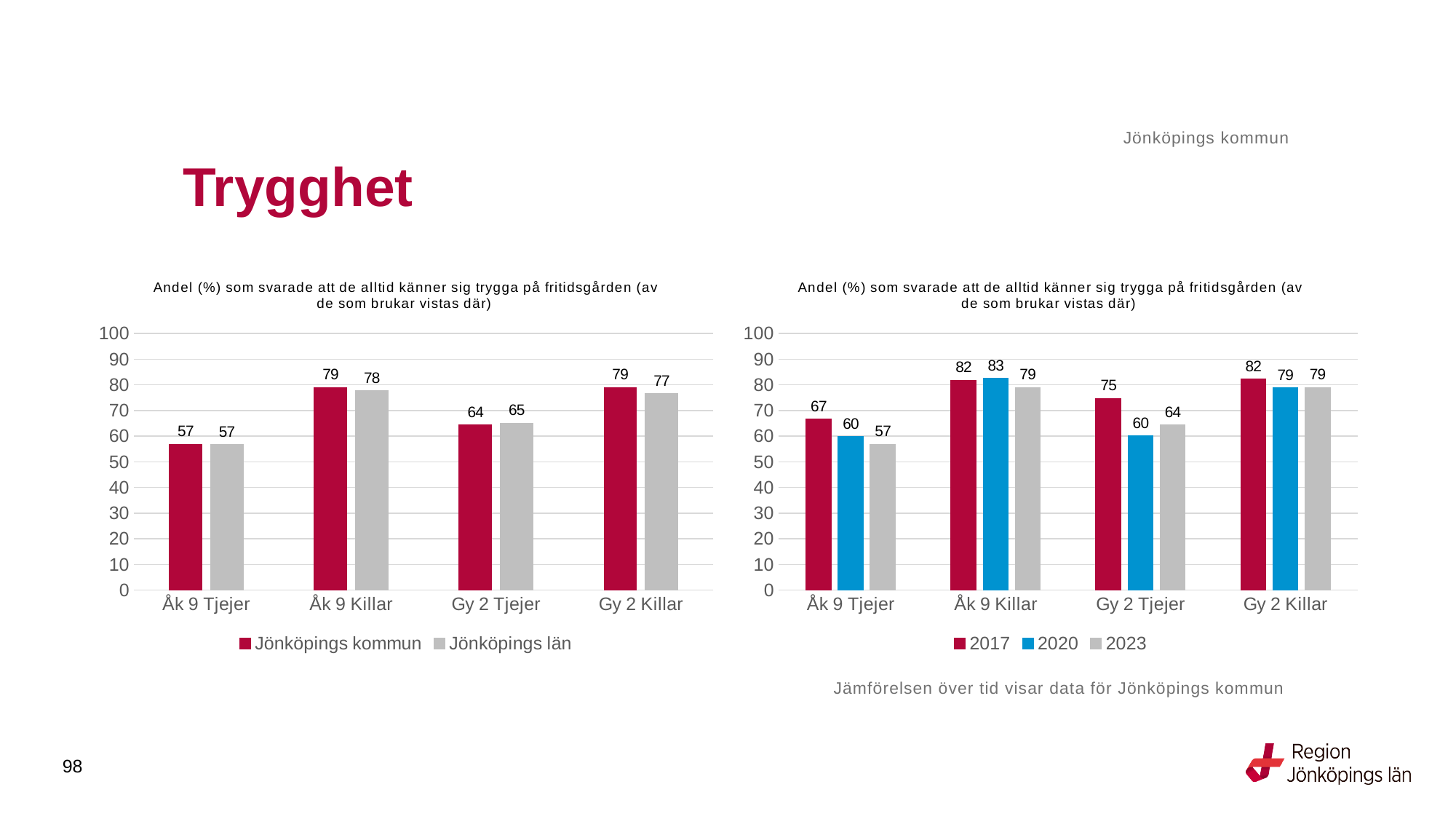
In the left chart, what is the value for Jönköpings län for Gy 2 Killar? 77 In the right chart, what is the value for 2023 for Gy 2 Tjejer? 64 In the left chart, what is the value for Jönköpings kommun for Åk 9 Tjejer? 57 In the right chart, which year has the lowest value for Åk 9 Tjejer? 2023 In the left chart, how many series does the legend list? 2 In the left chart, what is the difference between Jönköpings kommun and Jönköpings län for Gy 2 Killar? 2 In the left chart, which category has the lowest value for Jönköpings kommun? Åk 9 Tjejer What kind of chart is the right chart? Bar chart In the right chart, what is the value for 2020 for Åk 9 Killar? 83 In the right chart, what is the difference between 2017 and 2020 for Gy 2 Tjejer? 15 In the right chart, which is larger for Gy 2 Killar: the 2017 value or the 2023 value? 2017 In the right chart, how many series does the legend list? 3